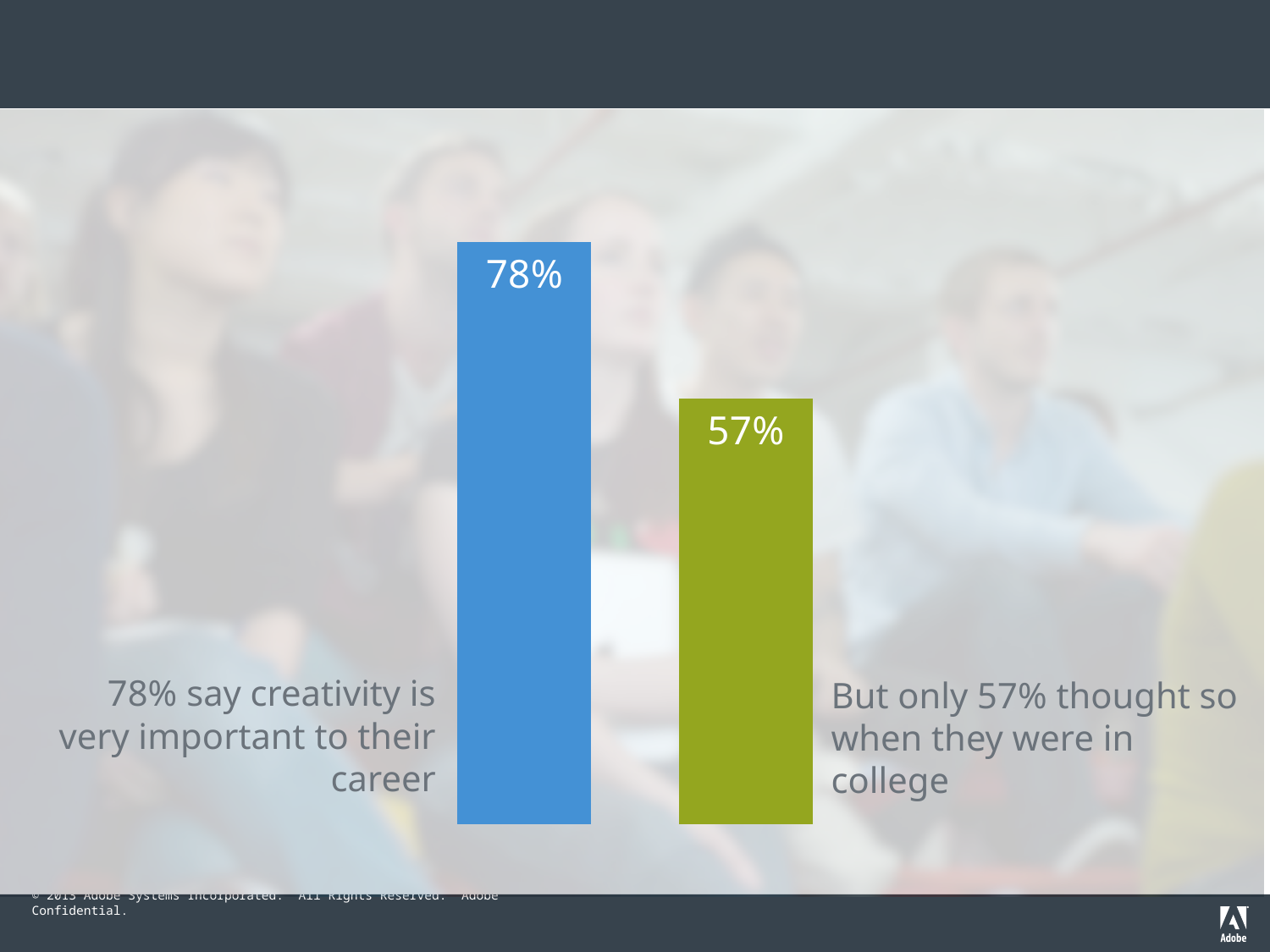
What is the highest value shown on the chart? 78% What kind of chart is shown on the slide? bar chart Which is larger: the share who say creativity is very important to their career now, or the share who thought so in college? very important to their career now What value is shown on the blue bar? 78% What is the difference in percentage points between the two bars? 21 percentage points What is the lowest value shown on the chart? 57% What colour is the bar labelled 57%? green What value is shown on the green bar? 57% What percentage say creativity is very important to their career? 78% Which bar shows the higher value, the blue bar or the green bar? the blue bar How many bars are plotted on the chart? 2 What percentage thought creativity was very important when they were in college? 57%